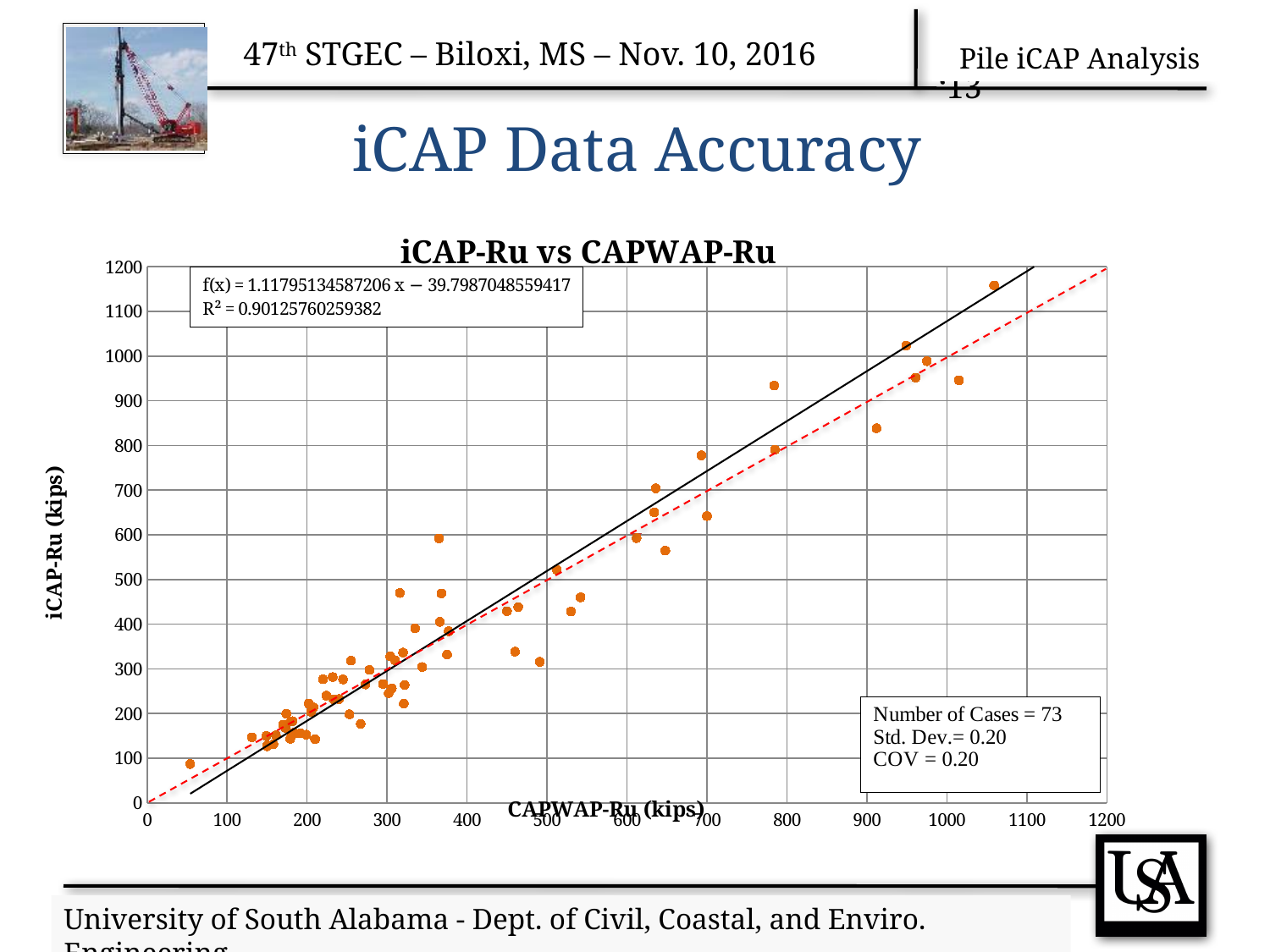
What kind of chart is shown on the slide? scatter chart What is the title of the chart? iCAP-Ru vs CAPWAP-Ru According to the text box on the chart, what is the Std. Dev.? 0.20 Is the iCAP-Ru value of the point at about 1000 kips CAPWAP-Ru greater or less than 900? greater What is the slope of the fitted line f(x) printed on the chart? 1.11795134587206 Do the iCAP-Ru values generally rise or fall as CAPWAP-Ru increases along the x axis? rise Is the iCAP-Ru value of the point with the lowest CAPWAP-Ru greater or less than 100? less According to the text box on the chart, what is the Number of Cases? 73 What R² value is printed on the chart for the trend line? 0.90125760259382 According to the text box on the chart, what is the COV? 0.20 Is the iCAP-Ru value of the point with the highest CAPWAP-Ru greater or less than 1100? greater What is the label of the y axis of the chart? iCAP-Ru (kips)